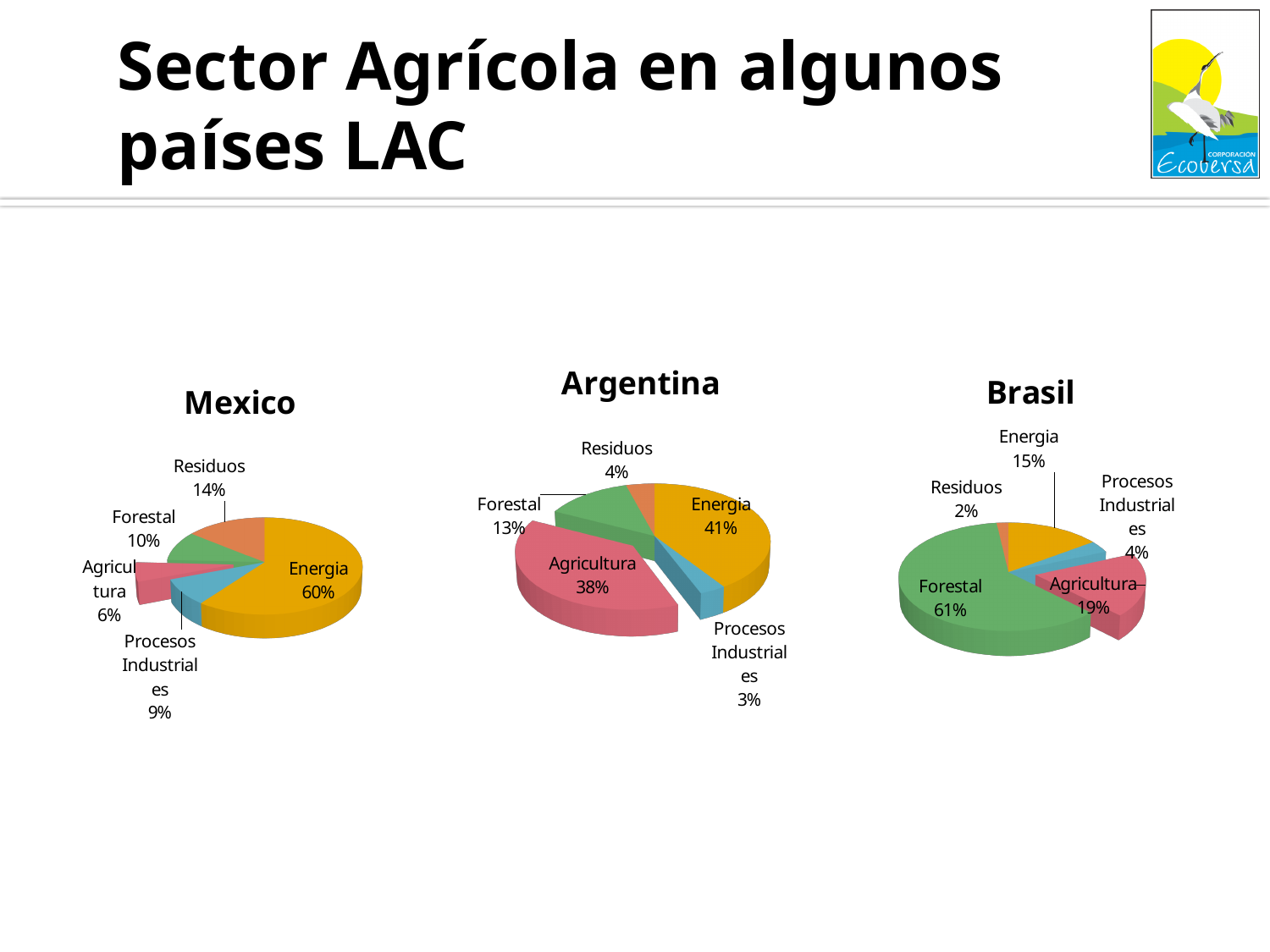
In the Brasil chart, what share does Forestal have? 61% In the Argentina chart, what share does Agricultura have? 38% How many pie charts are shown on the slide? 3 What type of chart is used for Mexico? Pie chart In the Mexico chart, what share does Energia have? 60% In the Mexico chart, what is the difference between the Residuos share and the Forestal share? 4% In the Mexico chart, which category has the smallest share? Agricultura In the Brasil chart, which category has the smallest share? Residuos In the Argentina chart, what is the difference between the Energia share and the Agricultura share? 3% How many slices does the Argentina pie chart have? 5 In the Argentina chart, which category has the largest share? Energia In the Brasil chart, which is larger, Agricultura or Energia? Agricultura